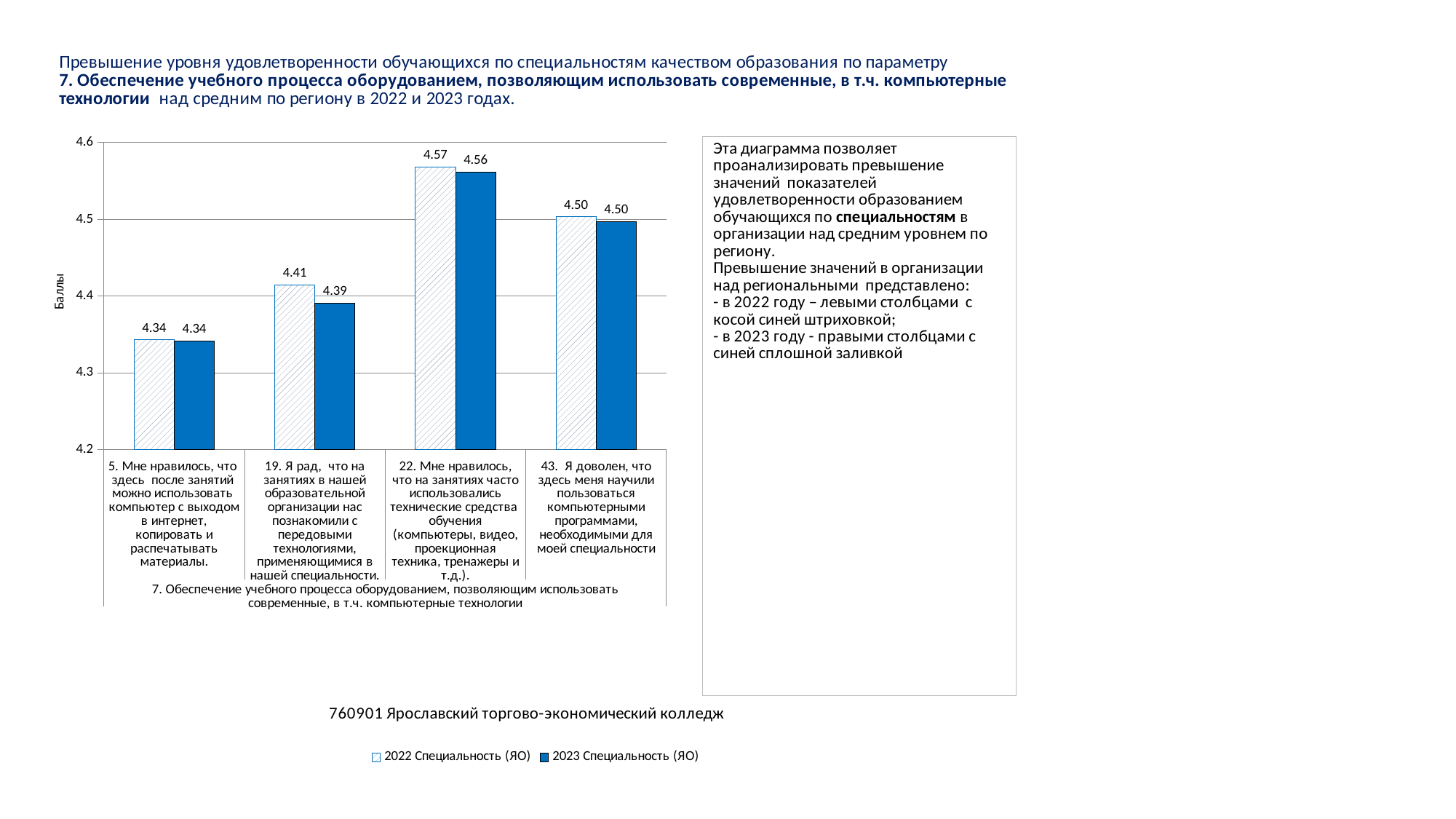
How many series does the chart legend list? 2 What is the difference between the 2022 and 2023 values for statement 19? 0.02 For statement 22, which series has the larger value, 2022 Специальность (ЯО) or 2023 Специальность (ЯО)? 2022 Специальность (ЯО) Which statement has the highest value in the 2022 Специальность (ЯО) series? 22. Мне нравилось, что на занятиях часто использовались технические средства обучения Which statement has the lowest value in the 2023 Специальность (ЯО) series? 5. Мне нравилось, что здесь после занятий можно использовать компьютер с выходом в интернет What is the value for the 2022 Специальность (ЯО) series for statement 5 ("Мне нравилось, что здесь после занятий можно использовать компьютер с выходом в интернет")? 4.34 What type of chart is shown on the slide? Bar chart How many statements (categories) are shown on the x axis of the chart? 4 What is the value for the 2023 Специальность (ЯО) series for statement 43 ("Я доволен, что здесь меня научили пользоваться компьютерными программами")? 4.50 What is the label of the vertical axis of the chart? Баллы What is the value for the 2023 Специальность (ЯО) series for statement 19 ("Я рад, что на занятиях в нашей образовательной организации нас познакомили с передовыми технологиями")? 4.39 What is the value for the 2022 Специальность (ЯО) series for statement 22 ("Мне нравилось, что на занятиях часто использовались технические средства обучения")? 4.57